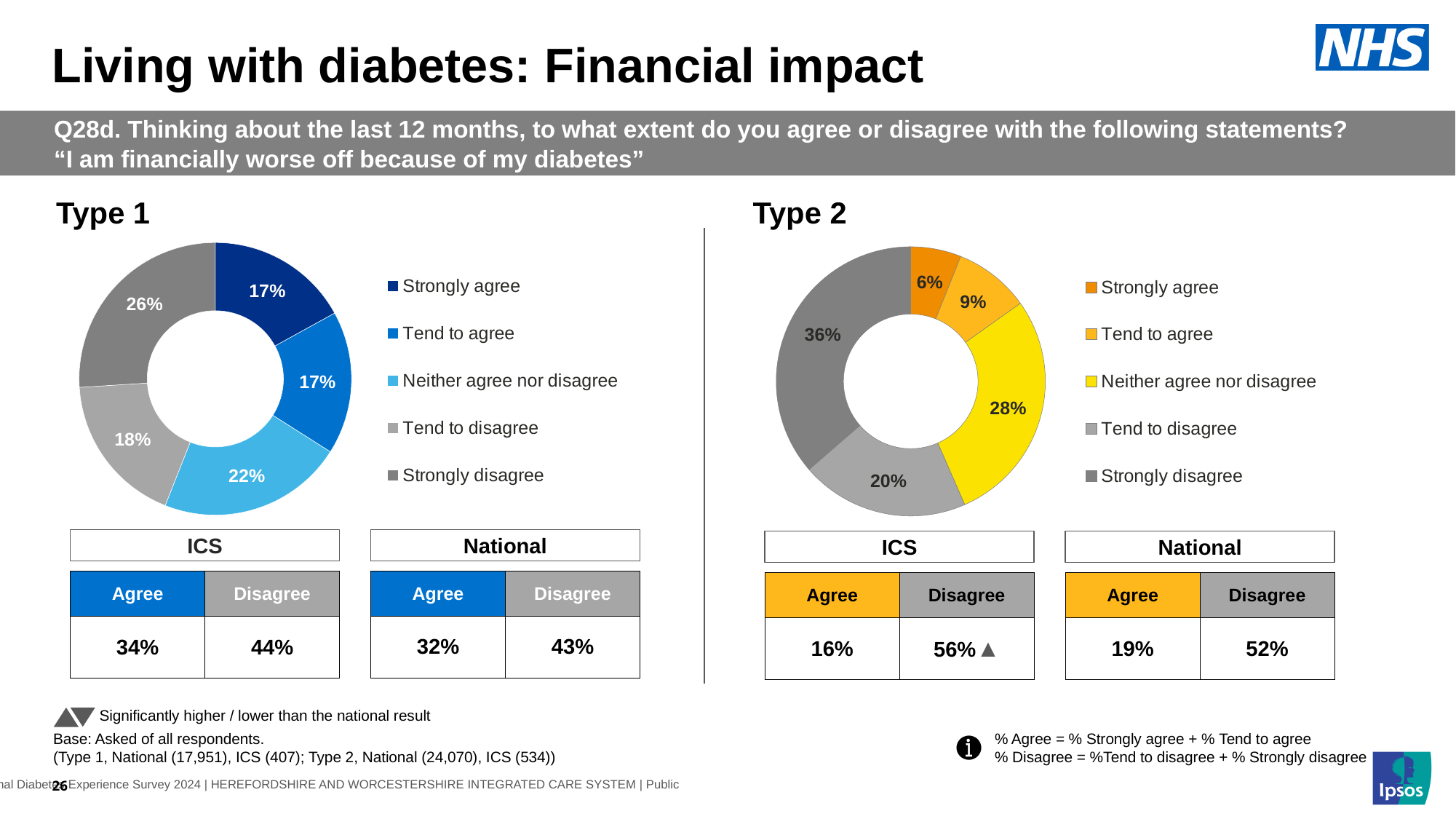
In the Type 2 chart, what is the difference in percentage points between 'Strongly disagree' and 'Neither agree nor disagree'? 8 In the Type 1 chart, which response category has the largest share? Strongly disagree In the Type 1 chart, what percentage of respondents said 'Neither agree nor disagree'? 22% In the Type 2 chart, what colour is the 'Neither agree nor disagree' segment? Yellow What type of chart is used to show the Type 1 results? Donut (pie) chart In the Type 2 chart, what percentage of respondents said 'Strongly agree'? 6% In the Type 2 chart, which response category has the smallest share? Strongly agree In the Type 2 chart, what percentage of respondents said 'Tend to disagree'? 20% How many response categories does the legend of the Type 2 chart list? 5 In the Type 1 chart, what percentage of respondents said 'Strongly disagree'? 26% In the Type 1 chart, which is larger: 'Neither agree nor disagree' or 'Tend to disagree'? Neither agree nor disagree In the Type 2 chart, which response category has the largest share? Strongly disagree